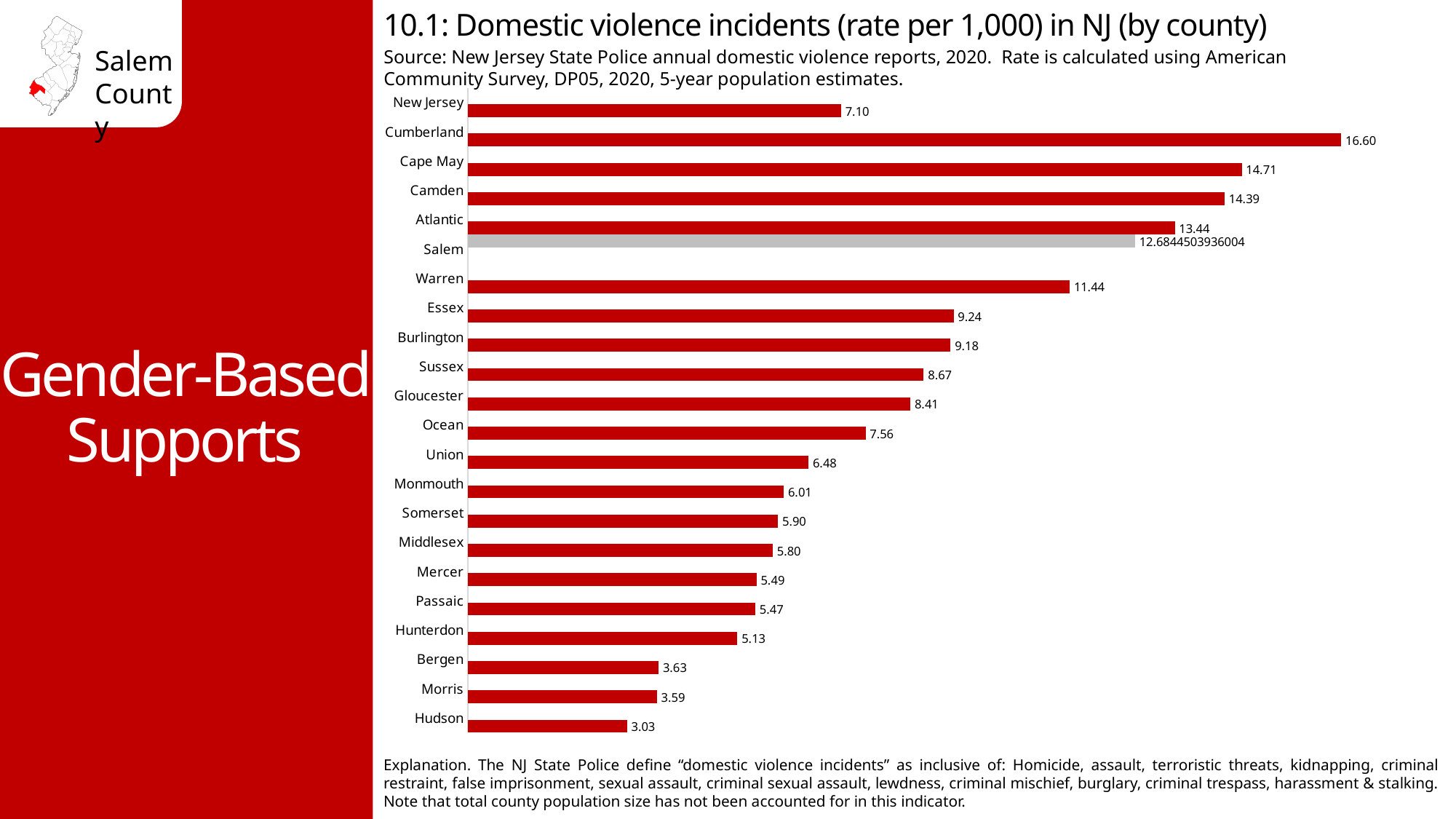
Which has a higher rate, Bergen or Morris? Bergen Which county has the highest domestic violence incident rate? Cumberland What is the rate for Warren? 11.44 What is the difference between the rates for Cumberland and Hudson? 13.57 What is the difference between the rates for Essex and Burlington? 0.06 How many bars are shown in the chart? 22 What value is printed for Salem? 12.6844503936004 Which has a higher rate, Cape May or Camden? Cape May What type of chart is used on this slide? Bar chart Which county has the lowest domestic violence incident rate? Hudson What is the rate shown for New Jersey as a whole? 7.10 What is the domestic violence incident rate for Cumberland? 16.60